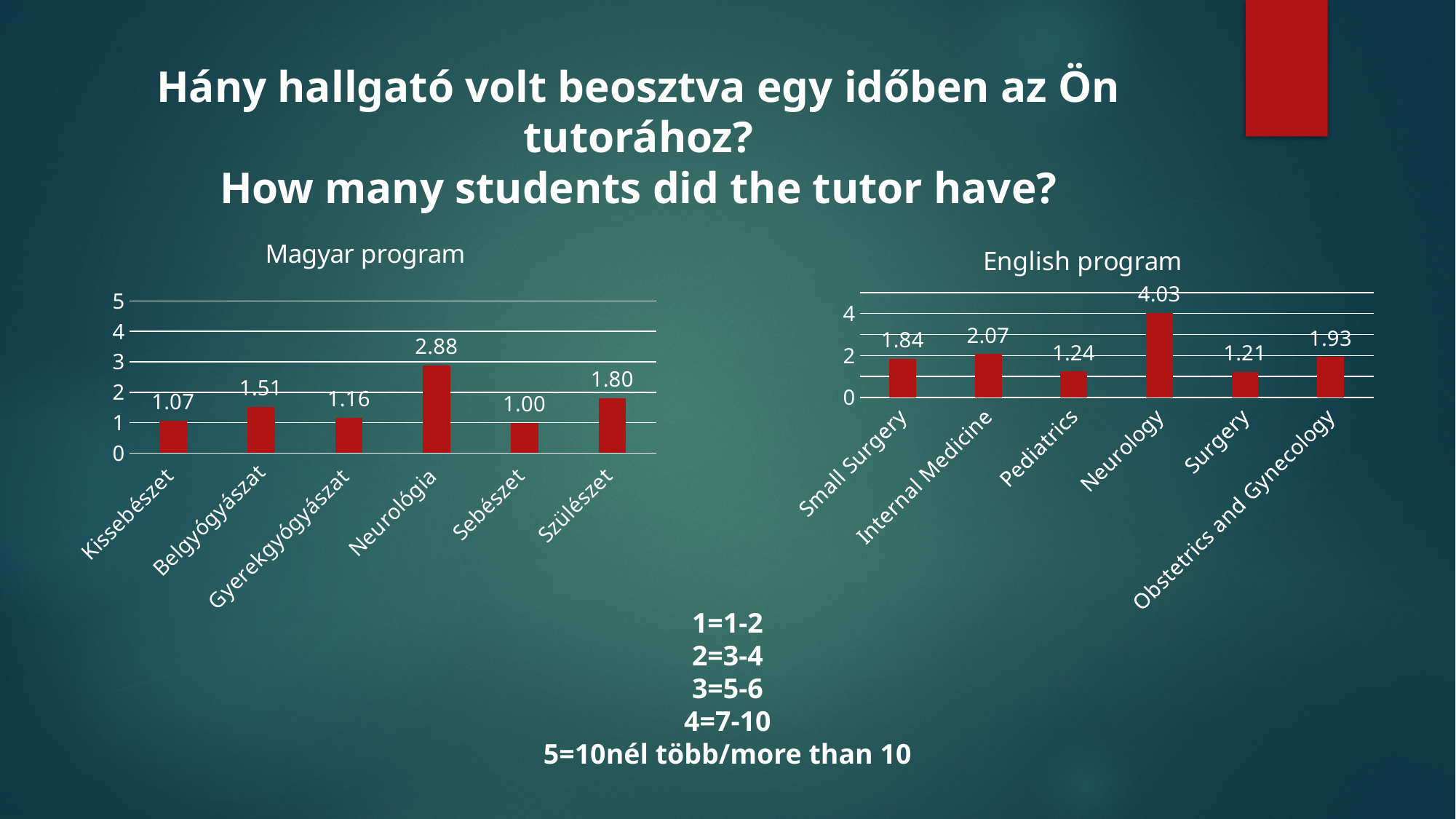
What kind of chart is the English program chart? bar chart In the Magyar program chart, which is larger, the value for Belgyógyászat or the value for Szülészet? Szülészet In the Magyar program chart, what is the value for Neurológia? 2.88 In the English program chart, what is the value for Pediatrics? 1.24 In the English program chart, which category has the highest value? Neurology In the Magyar program chart, what is the difference between the values for Neurológia and Kissebészet? 1.81 In the English program chart, which category has the lowest value? Surgery In the English program chart, what is the difference between the values for Neurology and Internal Medicine? 1.96 In the English program chart, is the value for Neurology greater or less than 3? greater How many categories are shown in the Magyar program chart? 6 In the Magyar program chart, which category has the lowest value? Sebészet In the Magyar program chart, what is the value for Gyerekgyógyászat? 1.16